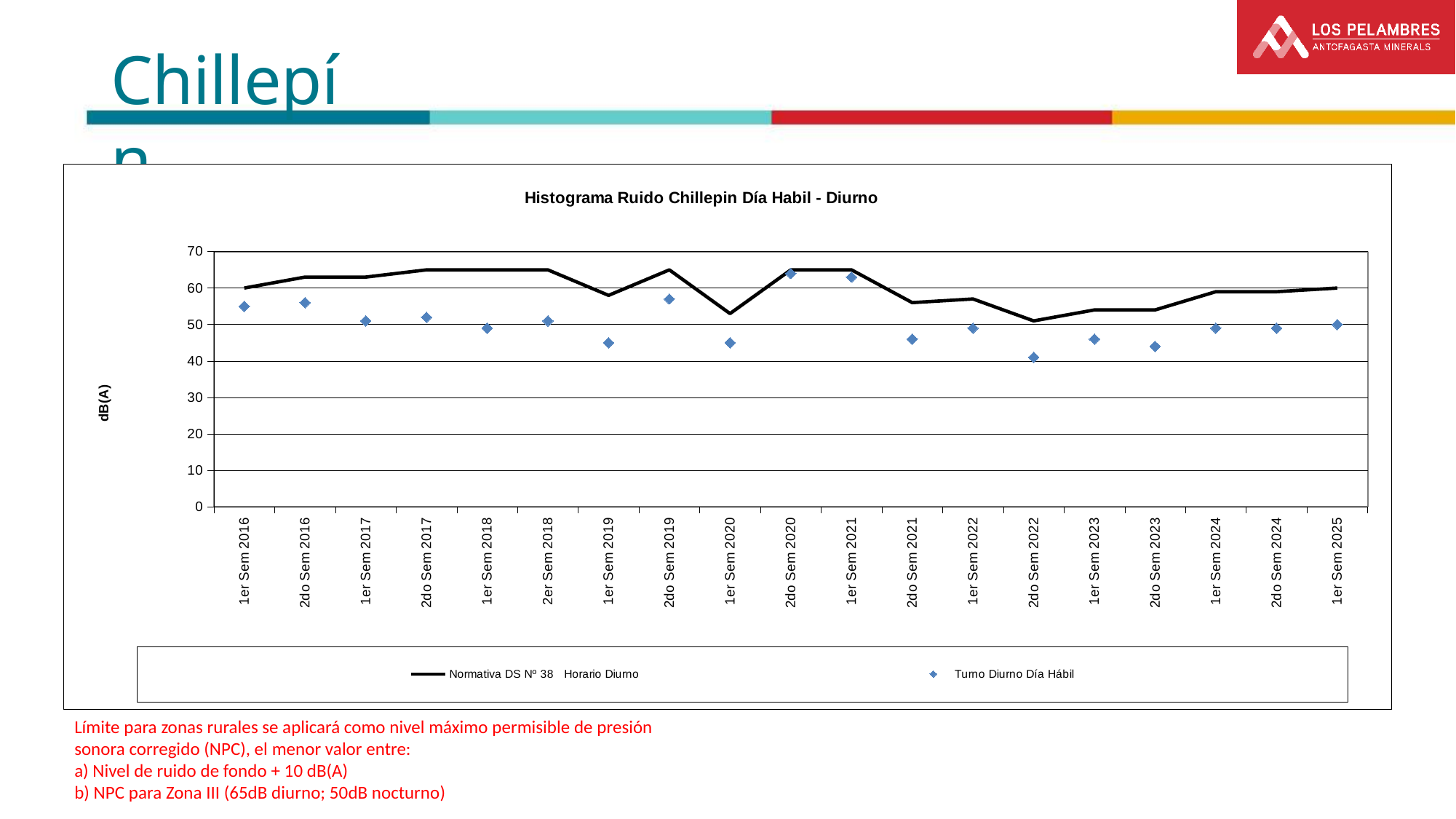
Is the Normativa DS Nº 38 Horario Diurno value for 2do Sem 2017 greater or less than 60? greater In which semester is the Turno Diurno Día Hábil value lowest? 2do Sem 2022 How many series does the chart legend list? 2 Is the Turno Diurno Día Hábil value for 2do Sem 2020 greater or less than 60? greater Is the Normativa DS Nº 38 Horario Diurno value for 1er Sem 2020 greater or less than 60? less How many semester categories are shown on the x axis? 19 Between 1er Sem 2020 and 2do Sem 2020, does the Turno Diurno Día Hábil value rise or fall? rise What is the label of the vertical axis? dB(A) What is the title of the chart? Histograma Ruido Chillepin Día Habil - Diurno Which is larger, the Turno Diurno Día Hábil value for 2do Sem 2016 or for 1er Sem 2019? 2do Sem 2016 What kind of chart is shown on the slide? line chart